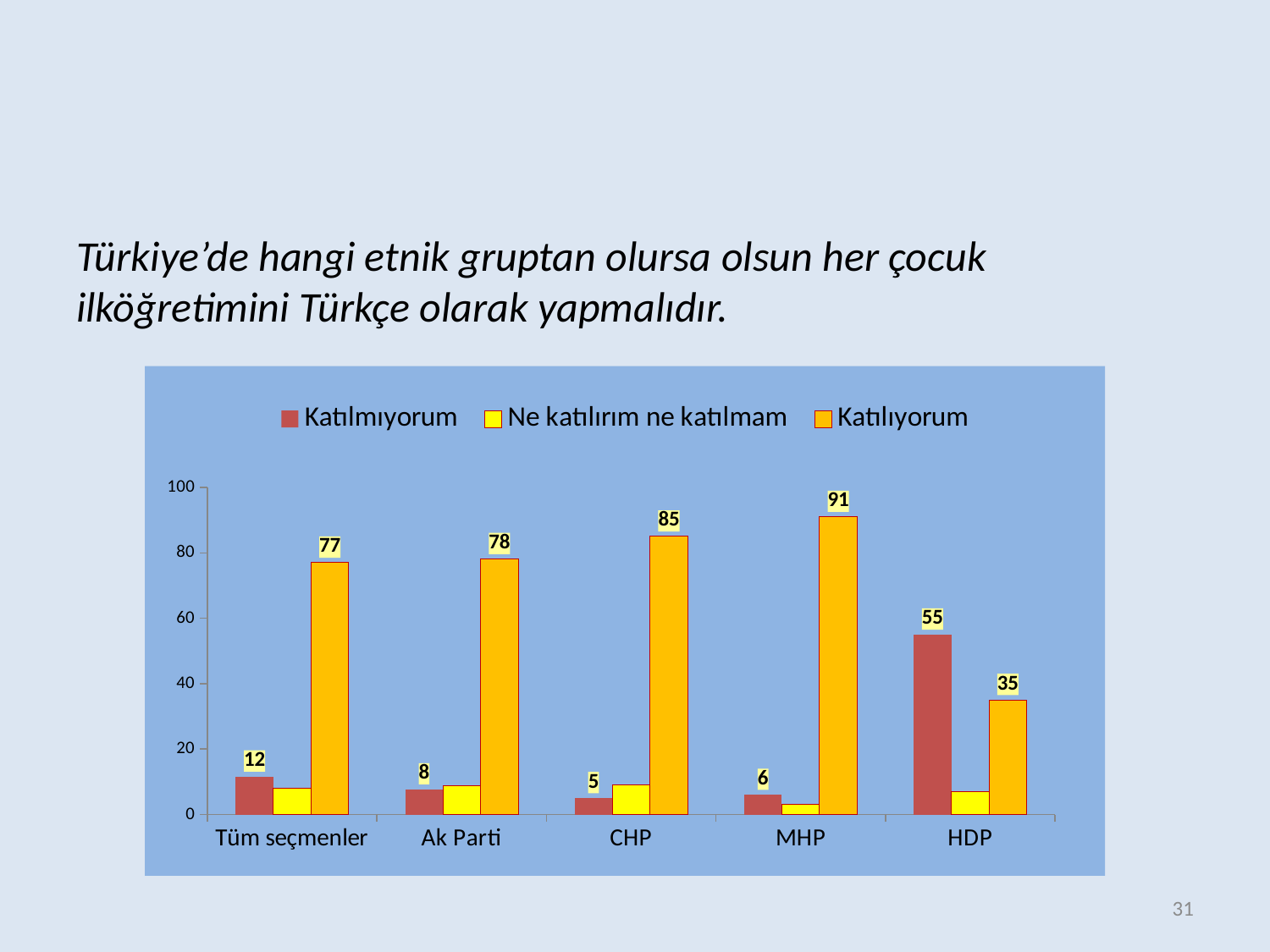
Which category has the lowest Katılmıyorum value? CHP What is the Katılmıyorum value for HDP? 55 What is the Katılıyorum value for MHP? 91 How many series does the legend list? 3 What is the difference between the Katılıyorum values for CHP and HDP? 50 Which is larger for Ak Parti: the Katılmıyorum value or the Katılıyorum value? Katılıyorum Is the Ne katılırım ne katılmam value for MHP greater or less than 20? less Which series is shown in orange? Katılıyorum How many categories are shown on the x axis? 5 What kind of chart is shown on the slide? bar chart What is the Katılıyorum value for Tüm seçmenler? 77 Which category has the highest Katılıyorum value? MHP